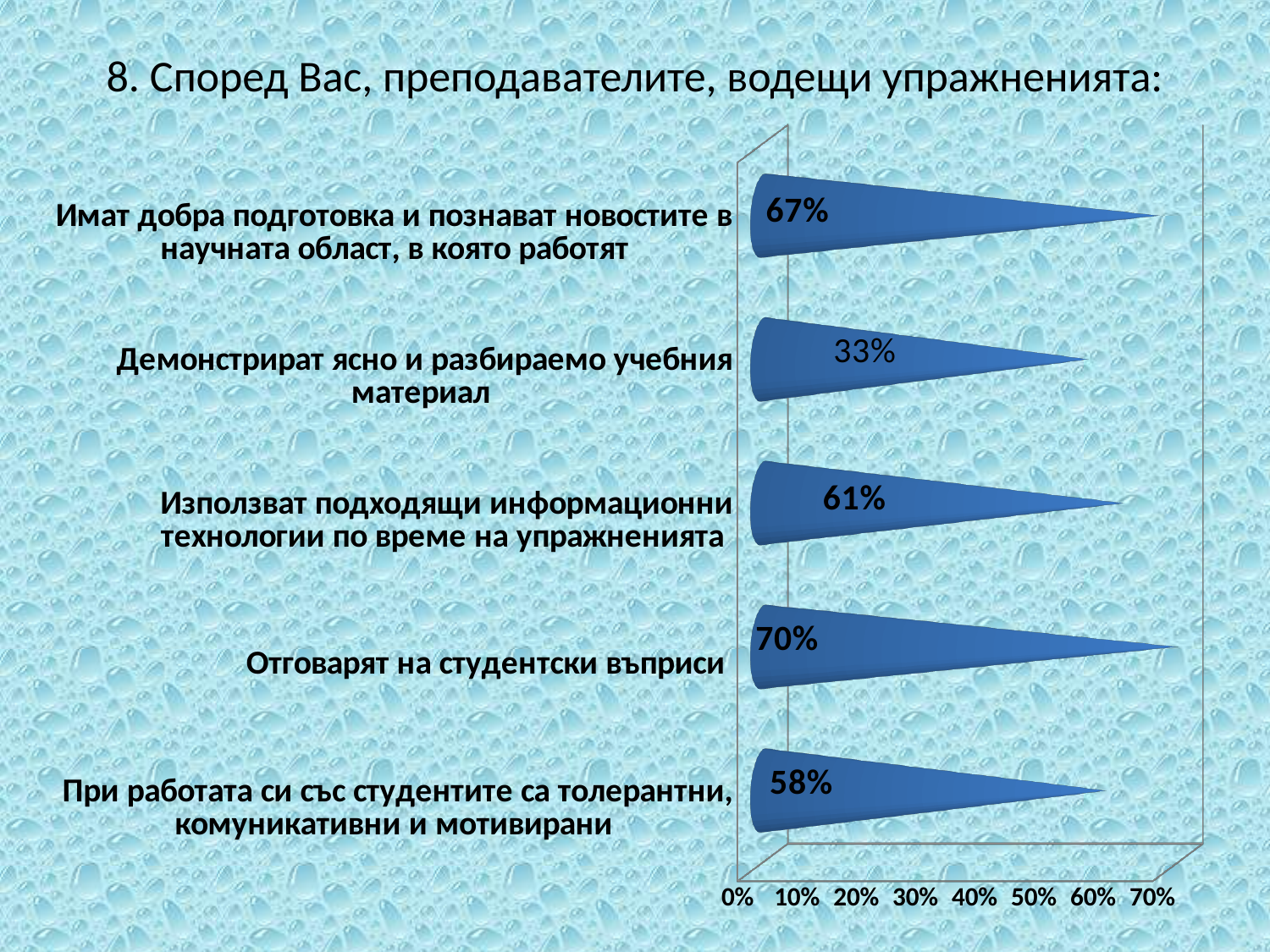
How many categories are shown in the chart? 5 Is the value for "При работата си със студентите са толерантни, комуникативни и мотивирани" greater or less than 50%? greater What value is shown for "Използват подходящи информационни технологии по време на упражненията"? 61% Which category has the highest value? Отговарят на студентски въприси What value is shown for "Отговарят на студентски въприси"? 70% What value is shown for "Демонстрират ясно и разбираемо учебния материал"? 33% What kind of chart is shown on the slide? bar chart Which category has the lowest value? Демонстрират ясно и разбираемо учебния материал What is the title of the slide? 8. Според Вас, преподавателите, водещи упражненията: What value is shown for "При работата си със студентите са толерантни, комуникативни и мотивирани"? 58% Which is larger: the value for "Имат добра подготовка и познават новостите в научната област, в която работят" or the value for "Използват подходящи информационни технологии по време на упражненията"? Имат добра подготовка и познават новостите в научната област, в която работят